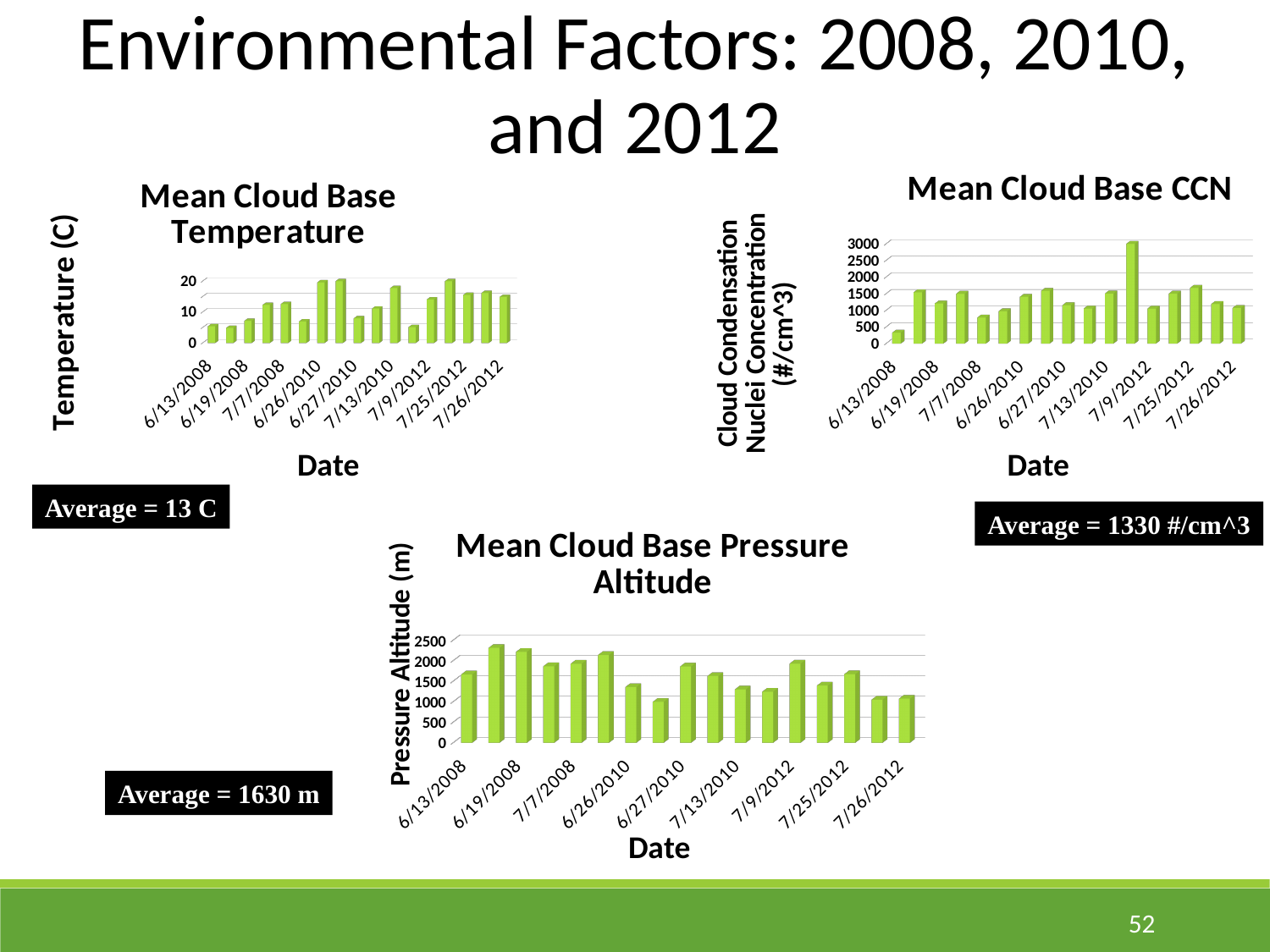
What average value is stated for the Mean Cloud Base CCN chart? 1330 #/cm^3 In the Mean Cloud Base CCN chart, is the value for 7/7/2008 greater or less than 1000? less In the Mean Cloud Base CCN chart, is the value for 6/13/2008 greater or less than 500? less In the Mean Cloud Base Pressure Altitude chart, is the value for 6/19/2008 greater or less than 2000? greater In the Mean Cloud Base CCN chart, which labeled date has the lowest value? 6/13/2008 What kind of chart is the Mean Cloud Base Temperature chart? bar chart In the Mean Cloud Base Temperature chart, which is larger, the value for 6/13/2008 or the value for 6/26/2010? 6/26/2010 In the Mean Cloud Base Pressure Altitude chart, which is larger, the value for 6/19/2008 or the value for 6/26/2010? 6/19/2008 How many charts are shown on the slide? 3